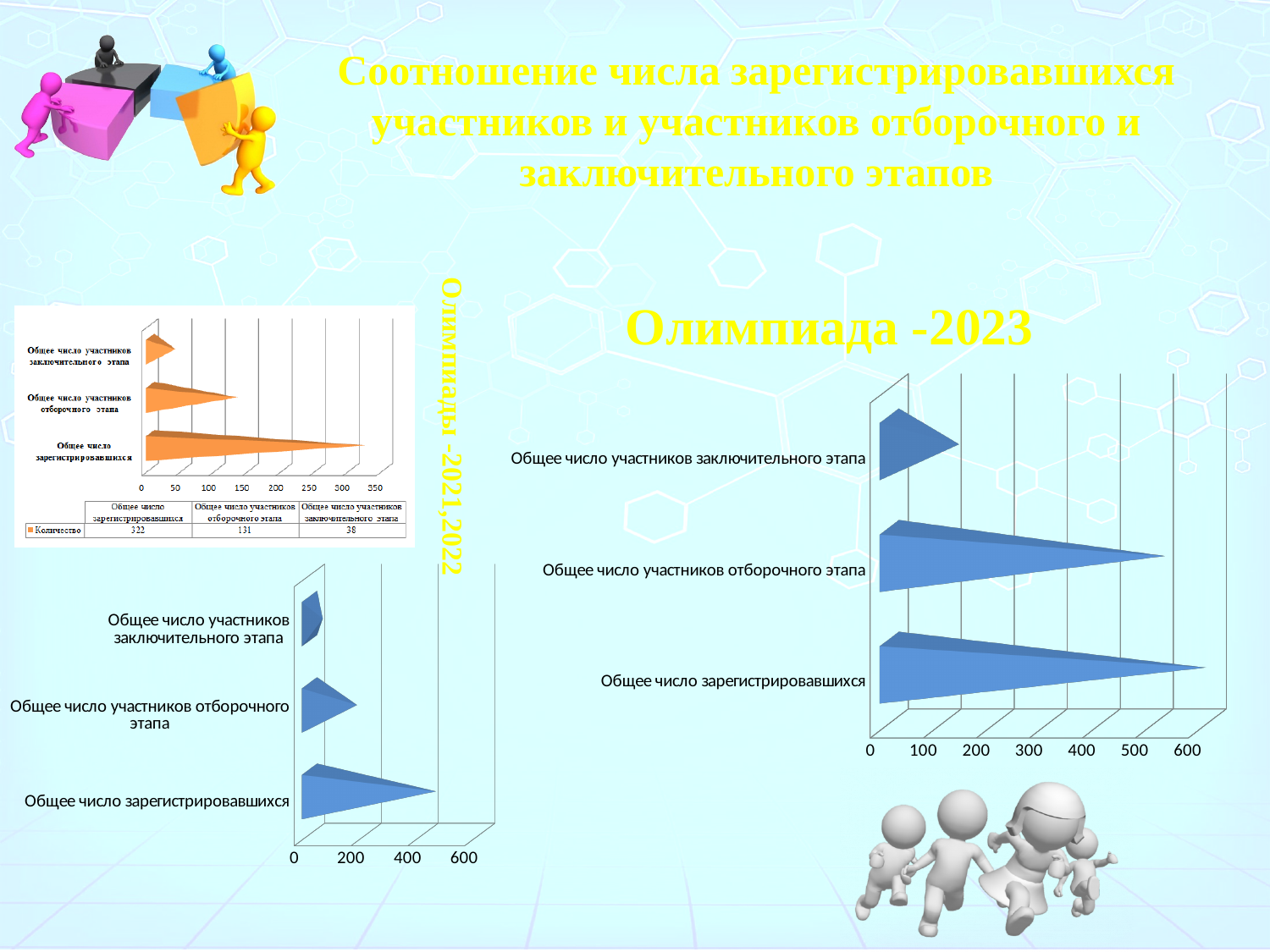
On the right chart (Олимпиада -2023), which category has the highest value? Общее число зарегистрировавшихся On the bottom-left chart, is the value for Общее число зарегистрировавшихся greater or less than 400? greater On the top-left chart, which category has the lowest value? Общее число участников заключительного этапа What kind of chart is the right chart (Олимпиада -2023)? bar chart On the bottom-left chart, is the value for Общее число участников заключительного этапа greater or less than 200? less On the top-left chart, what is the value for Общее число участников заключительного этапа? 38 On the top-left chart, what is the value for Общее число участников отборочного этапа? 131 On the right chart (Олимпиада -2023), is the value for Общее число участников отборочного этапа greater or less than 500? greater On the top-left chart, what is the difference between Общее число зарегистрировавшихся and Общее число участников отборочного этапа? 191 On the top-left chart, what is the value for Общее число зарегистрировавшихся? 322 On the right chart (Олимпиада -2023), how many categories are plotted? 3 On the top-left chart, what is the name of the series shown in the data table? Количество